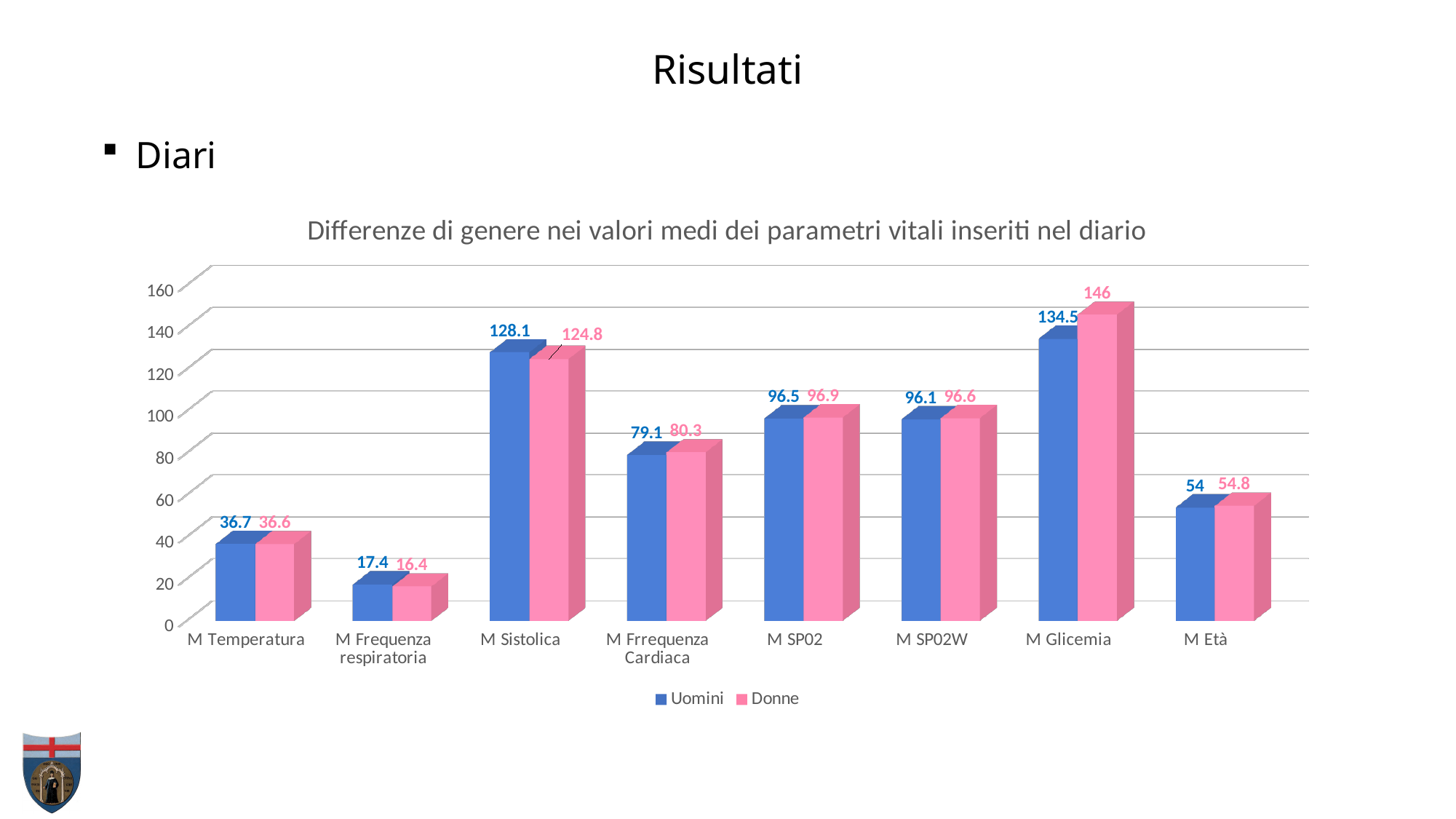
Which category has the highest Donne value? M Glicemia What is the title of the chart? Differenze di genere nei valori medi dei parametri vitali inseriti nel diario What kind of chart is shown on the slide? Bar chart What is the Uomini value for M Sistolica? 128.1 For M Sistolica, which series has the larger value, Uomini or Donne? Uomini Which category has the lowest Uomini value? M Frequenza respiratoria What is the Donne value for M Glicemia? 146 What is the Donne value for M Frequenza respiratoria? 16.4 How many categories are shown on the x axis? 8 What is the Uomini value for M Età? 54 What is the difference between the Donne and Uomini values for M Glicemia? 11.5 How many series does the legend list? 2